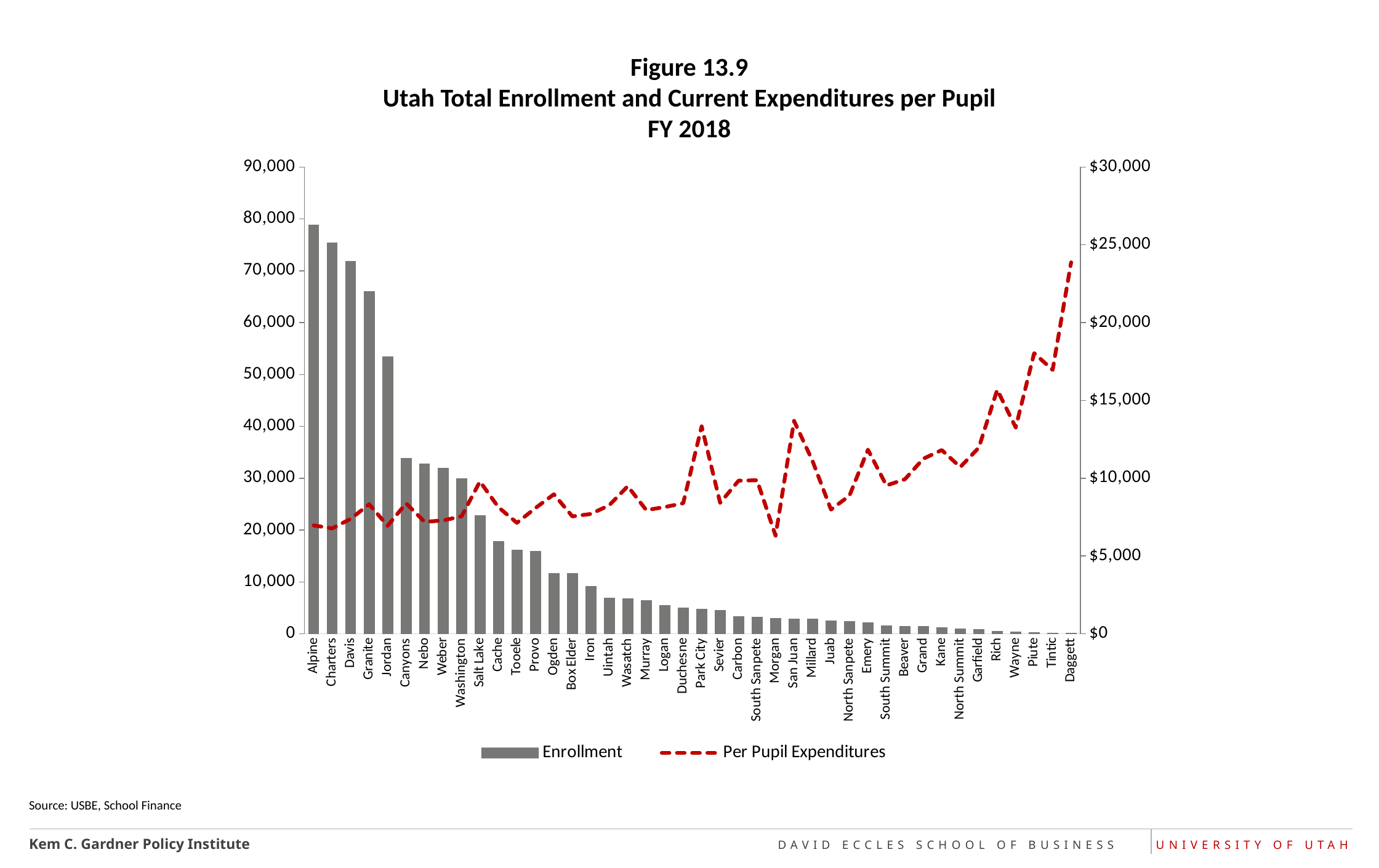
Which district has the highest per pupil expenditures? Daggett Are the per pupil expenditures for Daggett greater or less than $20,000? greater How many districts (categories) are shown on the x axis? 42 Is the enrollment for Canyons greater or less than 40,000? less Which district has the highest enrollment? Alpine What kind of chart is this? Bar chart with a dashed line series Is the enrollment for Jordan greater or less than 50,000? greater What are the two series named in the legend? Enrollment and Per Pupil Expenditures How many series does the legend list? 2 Which has the larger enrollment, Davis or Granite? Davis Do the enrollment bars rise or fall moving from left to right along the x axis? fall